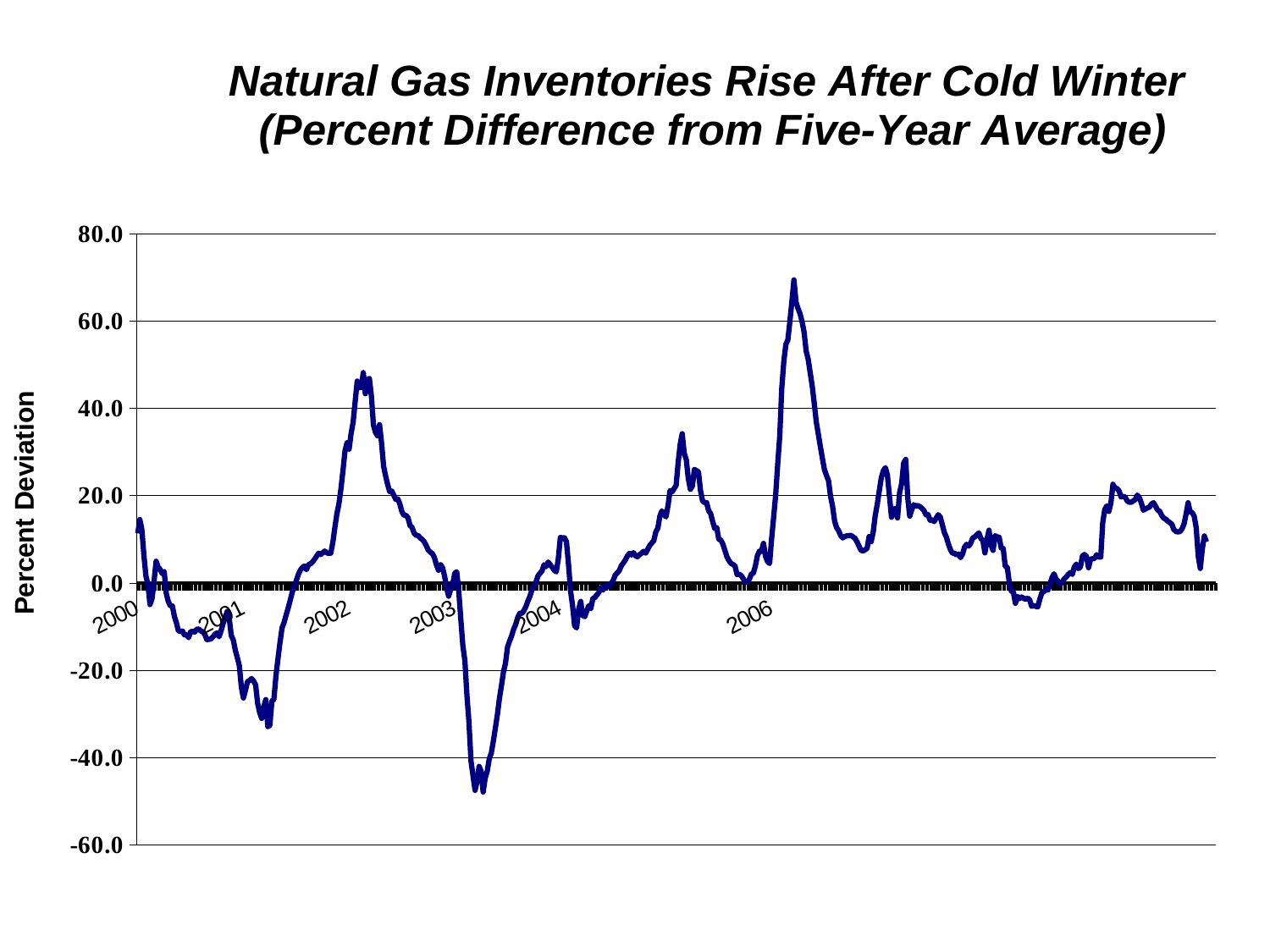
Which is lower, the trough in 2001 or the trough in 2003? the trough in 2003 Which is higher, the peak in 2002 or the peak in 2006? the peak in 2006 Is the peak of the line in 2002 greater or less than 40.0? greater Is the highest peak of the line, in 2006, greater or less than 60.0? greater In which labelled year does the line reach its lowest value? 2003 What is the label on the vertical axis? Percent Deviation What is the title of the chart? Natural Gas Inventories Rise After Cold Winter (Percent Difference from Five-Year Average) Is the lowest point of the line, in 2003, greater or less than -40.0? less What kind of chart is shown on the slide? line chart In which labelled year does the line reach its highest value? 2006